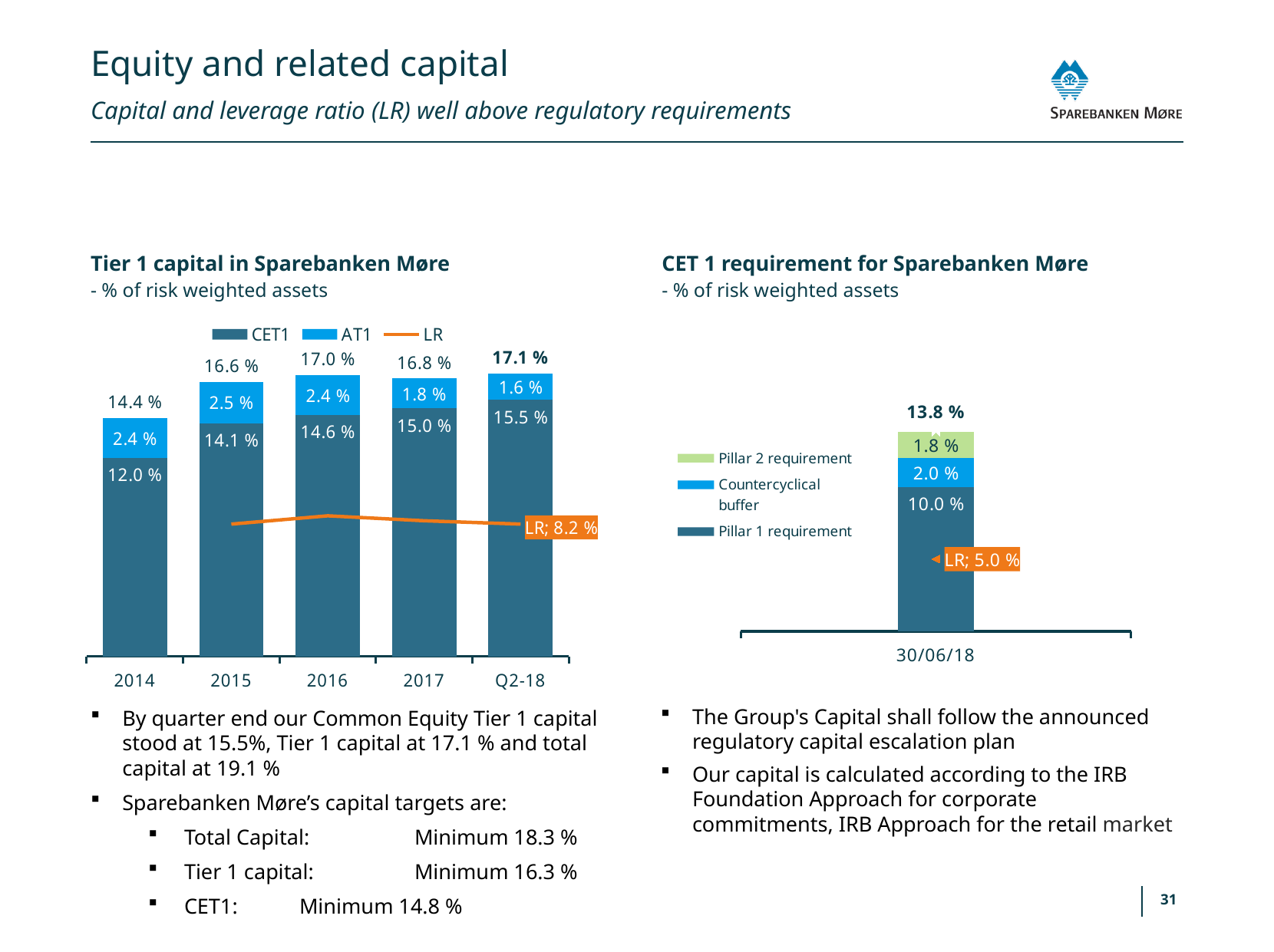
How many series does the legend of the 'Tier 1 capital in Sparebanken Møre' chart list? 3 In the 'Tier 1 capital in Sparebanken Møre' chart, what is the AT1 value for 2015? 2.5 % In the 'Tier 1 capital in Sparebanken Møre' chart, what is the difference between the CET1 values for Q2-18 and 2014? 3.5 % In the 'CET 1 requirement for Sparebanken Møre' chart, what is the Pillar 1 requirement value? 10.0 % In the 'Tier 1 capital in Sparebanken Møre' chart, is the AT1 value larger in 2016 or in 2017? 2016 In the 'Tier 1 capital in Sparebanken Møre' chart, what is the total Tier 1 capital shown for Q2-18? 17.1 % In the 'CET 1 requirement for Sparebanken Møre' chart, what is the total CET 1 requirement shown for 30/06/18? 13.8 % In the 'Tier 1 capital in Sparebanken Møre' chart, what is the LR value labelled for Q2-18? 8.2 % In the 'Tier 1 capital in Sparebanken Møre' chart, what is the CET1 value for 2016? 14.6 % In the 'Tier 1 capital in Sparebanken Møre' chart, which year has the lowest total Tier 1 capital? 2014 How many periods are shown on the x axis of the 'Tier 1 capital in Sparebanken Møre' chart? 5 In the 'Tier 1 capital in Sparebanken Møre' chart, does the CET1 value rise or fall from 2014 to Q2-18? rise